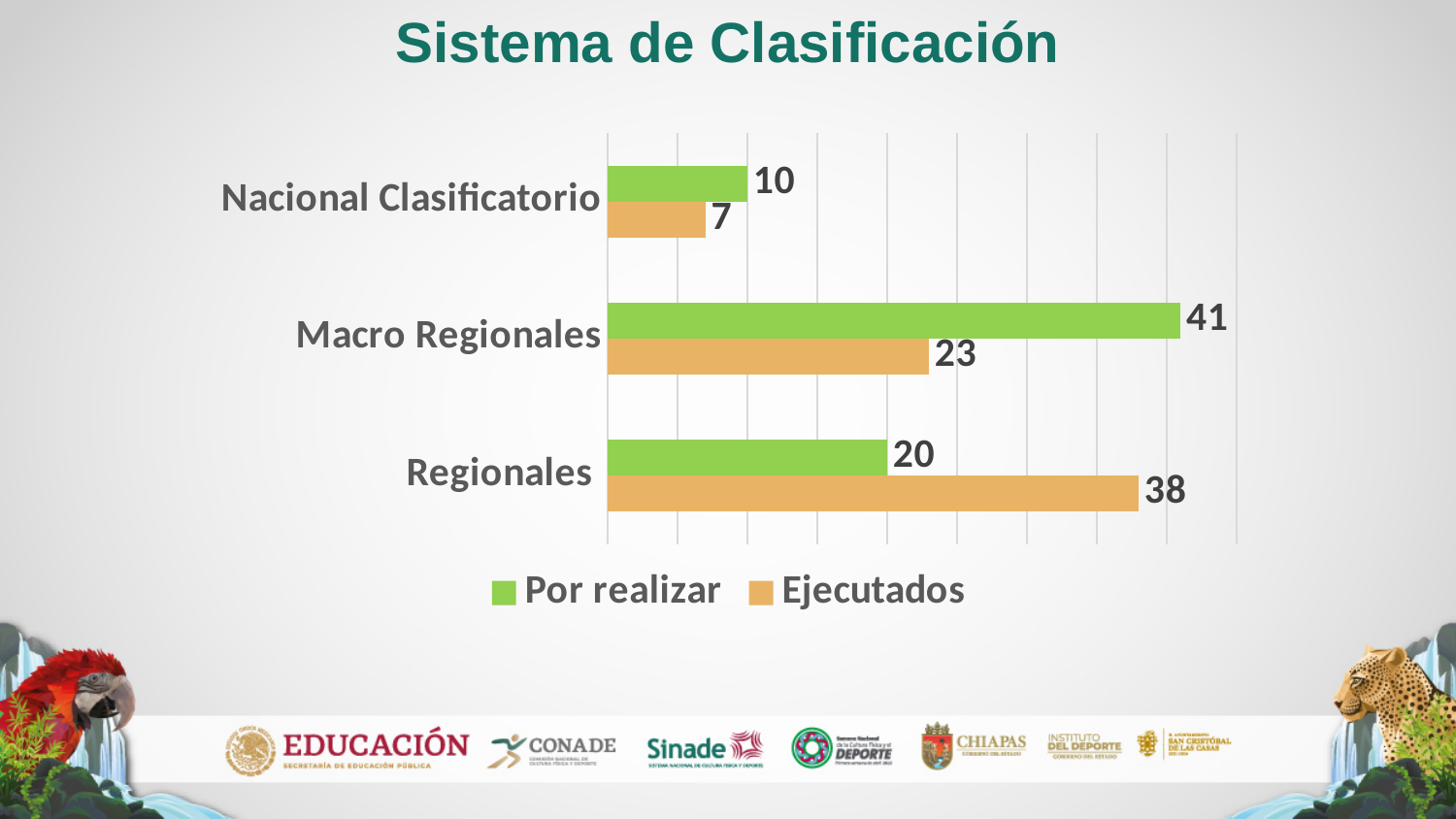
What is the title of the slide? Sistema de Clasificación How many categories are shown on the chart? 3 What is the value of Por realizar for Regionales? 20 For Regionales, which is larger: Por realizar or Ejecutados? Ejecutados What is the value of Ejecutados for Nacional Clasificatorio? 7 What is the value of Por realizar for Macro Regionales? 41 Which category has the lowest Ejecutados value? Nacional Clasificatorio What is the difference between Por realizar and Ejecutados for Macro Regionales? 18 How many series does the legend list? 2 What kind of chart is shown on the slide? Bar chart What is the value of Ejecutados for Regionales? 38 Which category has the highest Por realizar value? Macro Regionales